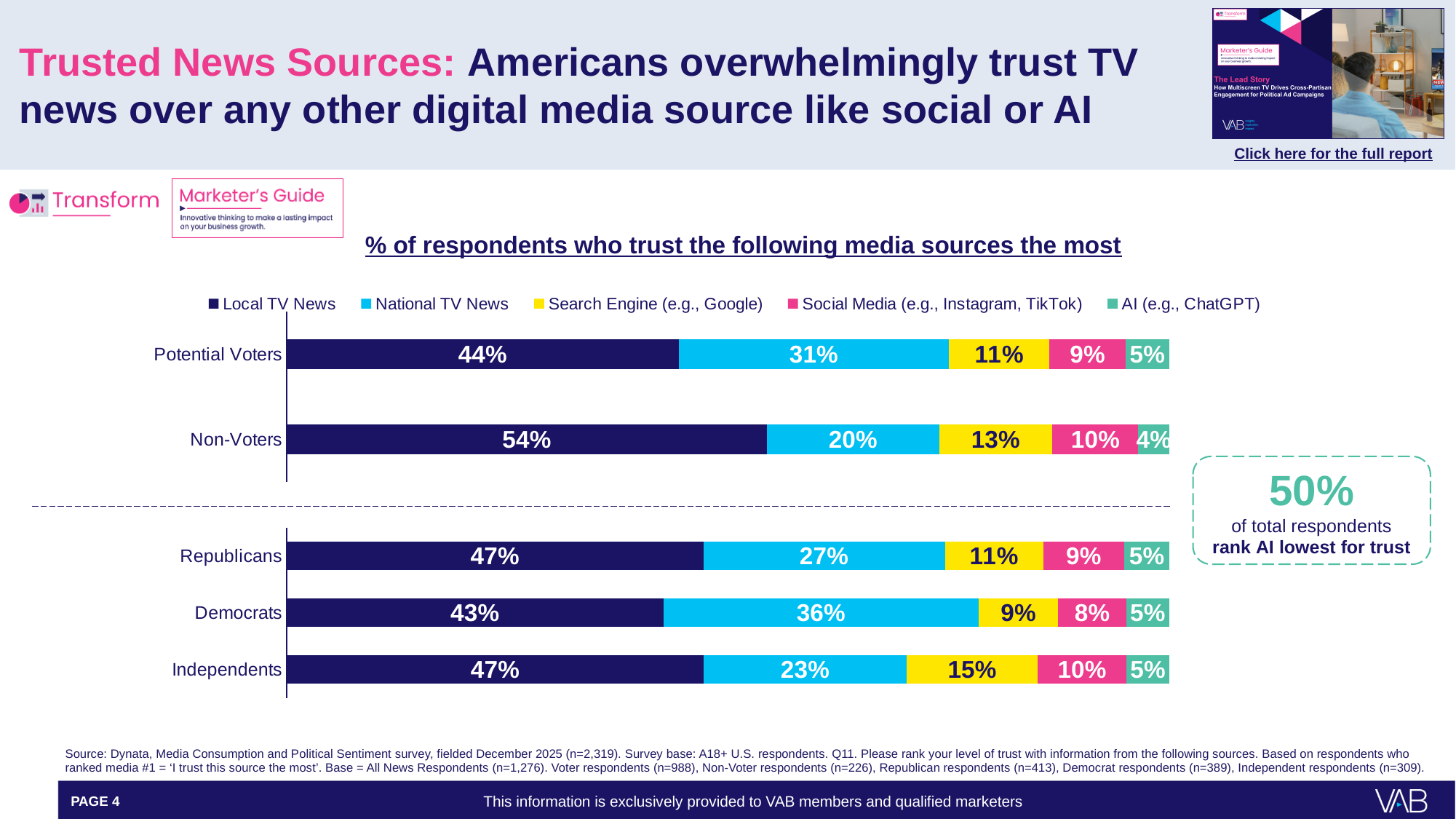
What is the difference between the Local TV News share for Non-Voters and for Democrats? 11% Which is larger: the National TV News share for Republicans or for Independents? Republicans What kind of chart is shown on the slide? Stacked bar chart Which group has the highest share trusting Local TV News the most? Non-Voters Which group has the lowest share trusting National TV News the most? Non-Voters What percentage of Democrats trust National TV News the most? 36% What is the total of the stacked bar for Potential Voters? 100% What percentage of Non-Voters trust AI (e.g., ChatGPT) the most? 4% How many groups (categories) are shown in the chart? 5 How many series does the legend list? 5 What percentage of Non-Voters trust Local TV News the most? 54% What percentage of Independents trust Search Engine (e.g., Google) the most? 15%